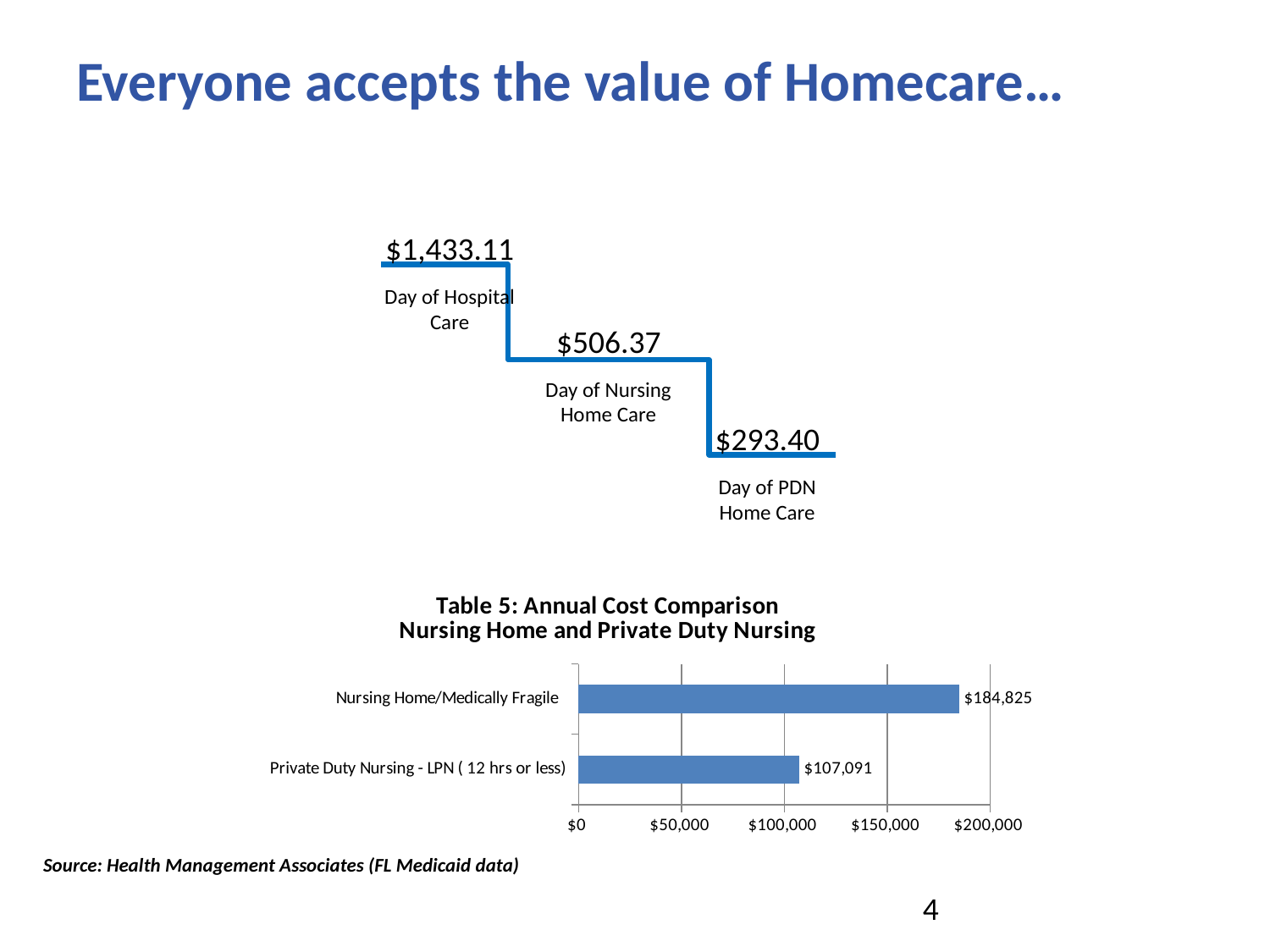
In the bottom chart titled 'Table 5: Annual Cost Comparison', which category has the highest value? Nursing Home/Medically Fragile In the bottom chart titled 'Table 5: Annual Cost Comparison', what is the difference between the Nursing Home/Medically Fragile value and the Private Duty Nursing - LPN value? $77,734 In the bottom chart titled 'Table 5: Annual Cost Comparison', what is the value for Nursing Home/Medically Fragile? $184,825 In the bottom chart titled 'Table 5: Annual Cost Comparison', what is the value for Private Duty Nursing - LPN (12 hrs or less)? $107,091 In the top chart, what is the cost shown for a Day of Nursing Home Care? $506.37 What kind of chart is the bottom chart titled 'Table 5: Annual Cost Comparison'? Bar chart In the top chart, which category has the lowest value? Day of PDN Home Care In the bottom chart titled 'Table 5: Annual Cost Comparison', is the value for Private Duty Nursing - LPN greater or less than $150,000? less In the bottom chart titled 'Table 5: Annual Cost Comparison', how many categories are plotted? 2 In the top chart, do the values rise or fall from left to right? Fall In the top chart, what is the cost shown for a Day of PDN Home Care? $293.40 In the top chart, what is the cost shown for a Day of Hospital Care? $1,433.11